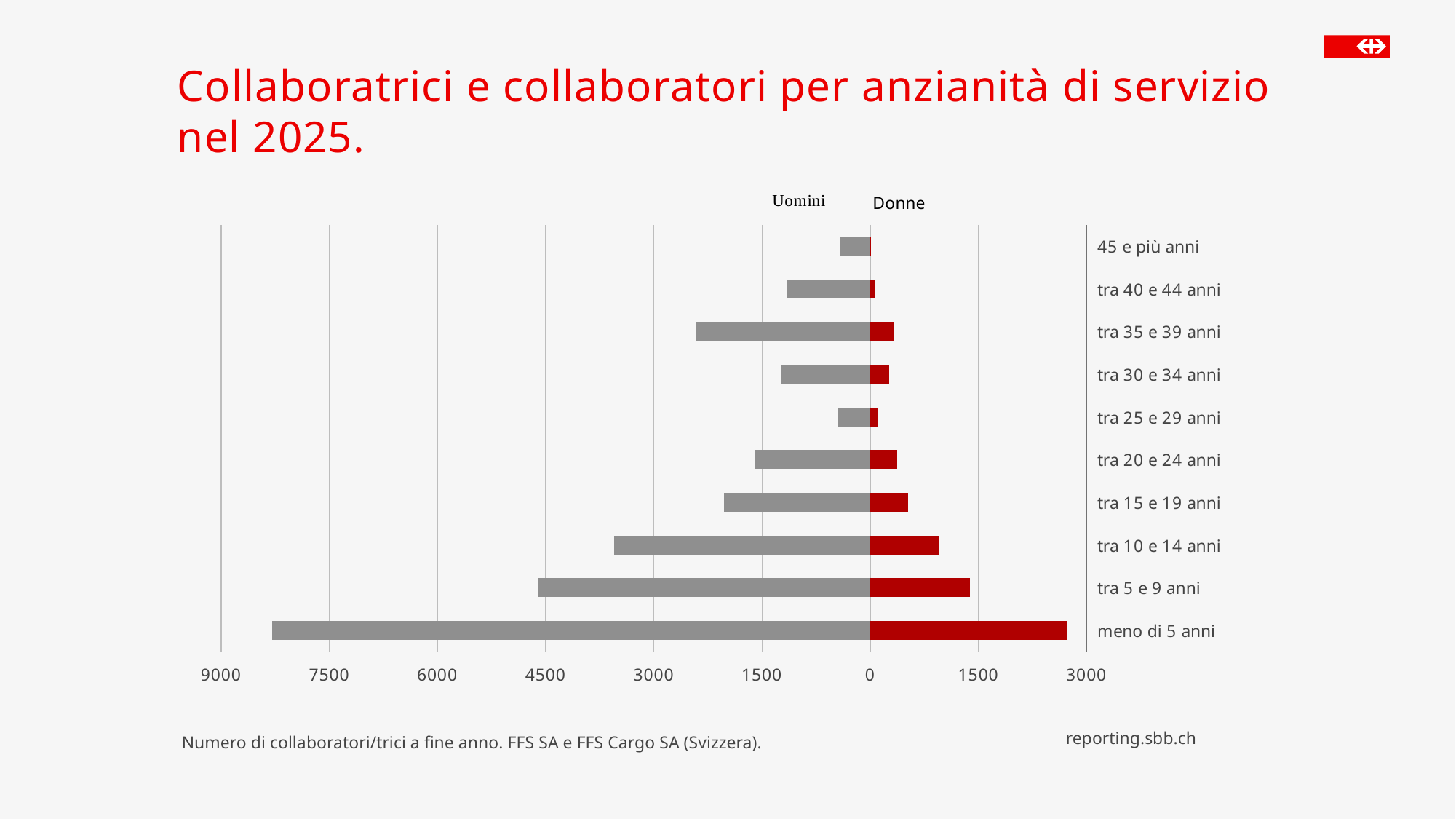
Which category has the highest value for Donne? meno di 5 anni Is the Uomini value for 'meno di 5 anni' greater or less than 7500? greater Is the Uomini value for 'tra 10 e 14 anni' greater or less than 3000? greater How many series does the chart show? 2 Which category has the lowest value for Donne? 45 e più anni Which two series are shown on the chart? Uomini and Donne For Uomini, which is larger: 'tra 35 e 39 anni' or 'tra 30 e 34 anni'? tra 35 e 39 anni How many service-seniority categories are plotted on the chart? 10 Which category has the highest value for Uomini? meno di 5 anni Is the Donne value for 'tra 10 e 14 anni' greater or less than 1500? less What kind of chart is shown on the slide? bar chart